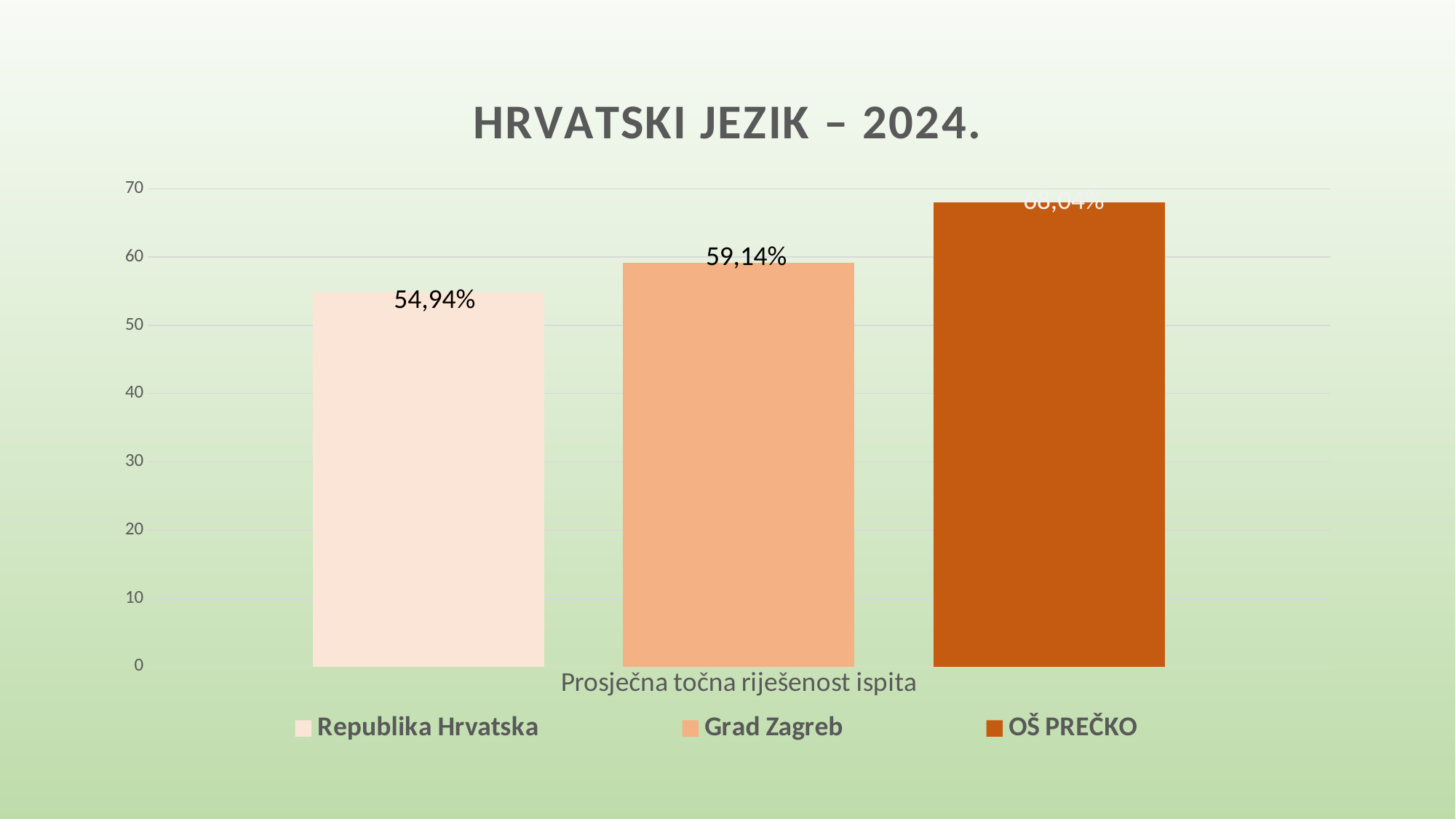
What kind of chart is shown on the slide? bar chart Is the value for OŠ PREČKO greater or less than 70? less What is the value for Grad Zagreb? 59,14% Which series has the highest bar? OŠ PREČKO How many series does the legend list? 3 What is the difference between the values for Grad Zagreb and Republika Hrvatska? 4,20% What is the value for Republika Hrvatska? 54,94% Which is larger, the value for Grad Zagreb or the value for Republika Hrvatska? Grad Zagreb How many bars are plotted on the chart? 3 Is the value for OŠ PREČKO greater or less than 60? greater What is the title of the chart? HRVATSKI JEZIK – 2024. Which series has the lowest bar? Republika Hrvatska